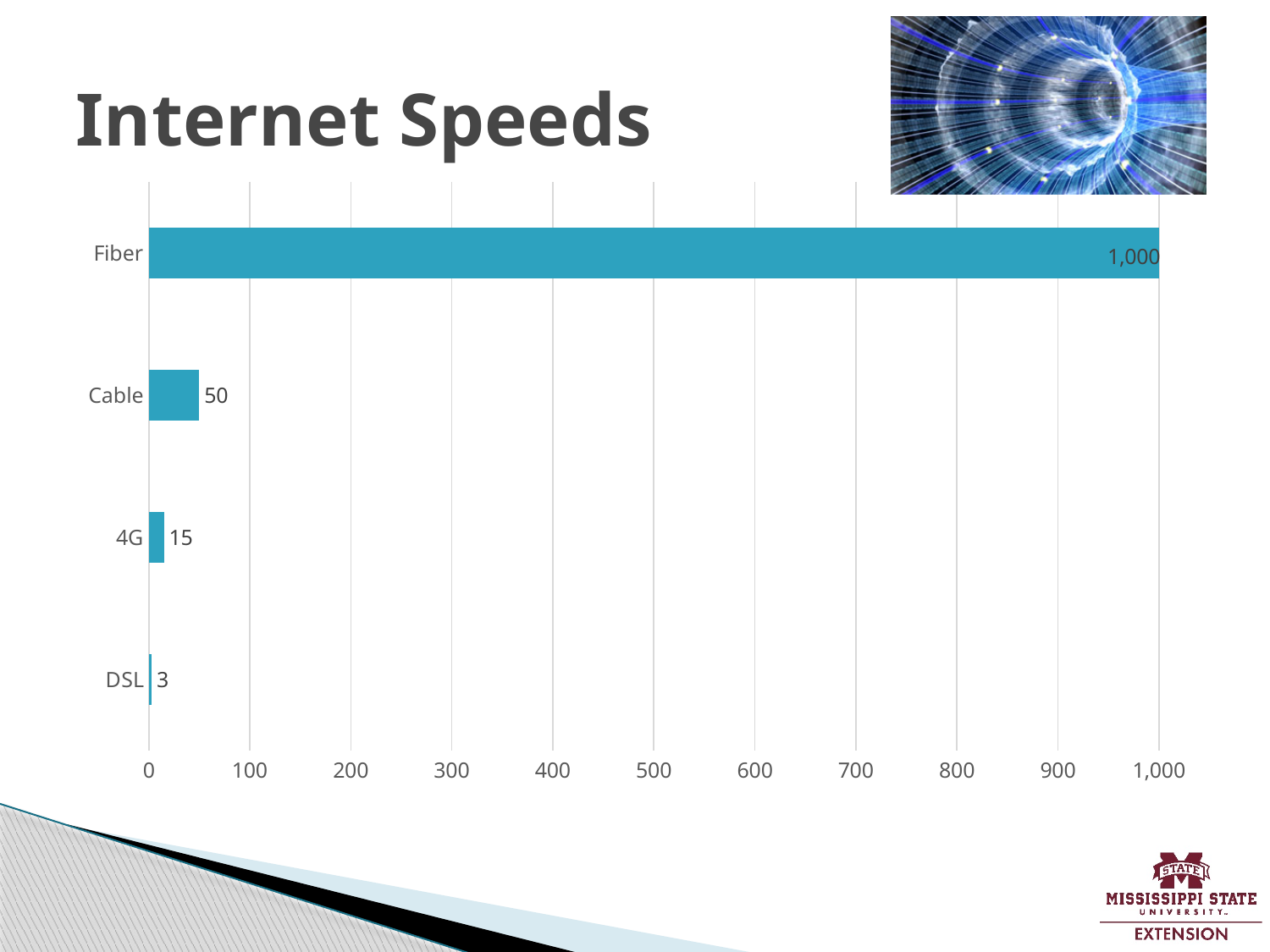
What is the difference between the values for Fiber and Cable? 950 What is the value for DSL? 3 Which category has the highest value? Fiber What kind of chart is shown on the slide? bar chart How many categories are shown in the chart? 4 What is the difference between the values for Cable and 4G? 35 What is the value for 4G? 15 What is the value for Fiber? 1,000 Is the value for Cable greater or less than 100? less What is the value for Cable? 50 Which is larger, the value for 4G or the value for DSL? 4G Which category has the lowest value? DSL